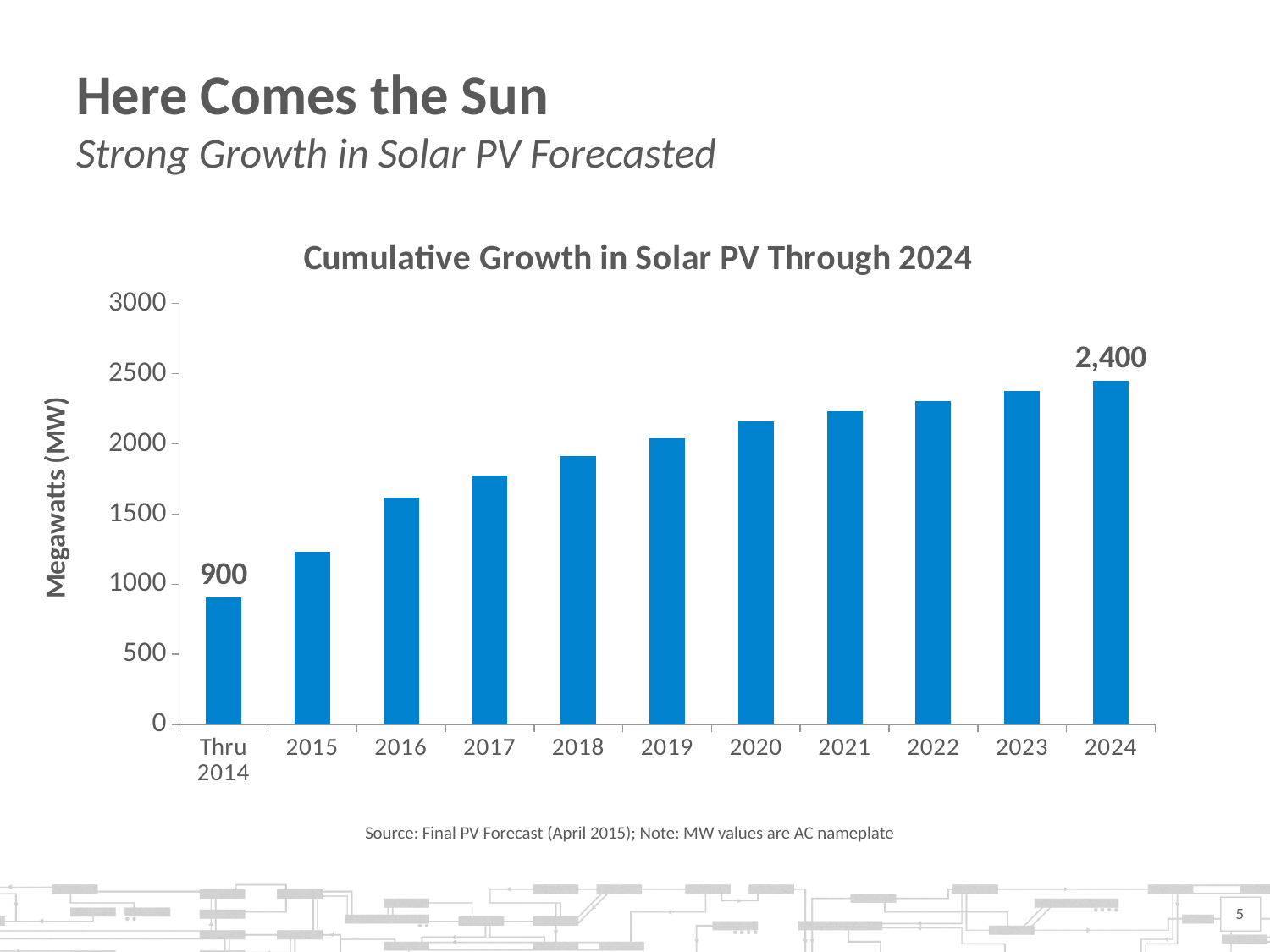
Do the values rise or fall from Thru 2014 to 2024? rise What is the value for 2024? 2,400 Is the value for 2018 greater or less than 2000? less Which is larger, the value for 2016 or the value for 2020? 2020 What kind of chart is shown? bar chart Which year has the highest value? 2024 What is the title of the chart? Cumulative Growth in Solar PV Through 2024 What is the difference between the values for 2024 and Thru 2014? 1,500 Which category has the lowest value? Thru 2014 What is the value for Thru 2014? 900 Is the value for 2021 greater or less than 2000? greater How many bars are shown in the chart? 11